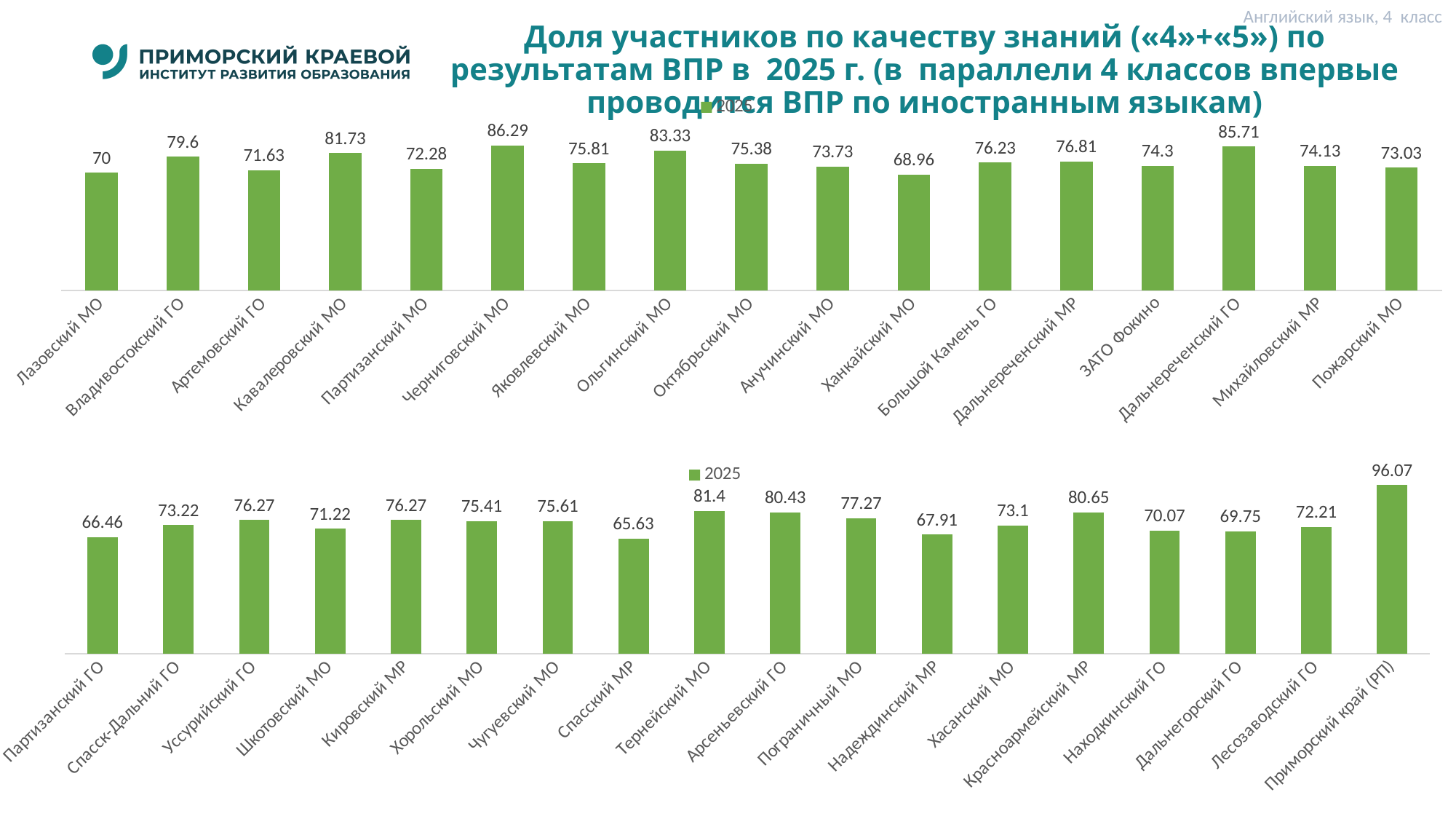
In the top chart, what is the value for Ханкайский МО? 68.96 In the bottom chart, what is the value for Приморский край (РП)? 96.07 In the top chart, what is the difference between Ольгинский МО and Лазовский МО? 13.33 In the top chart, which category has the highest value? Черниговский МО In the bottom chart, which category has the lowest value? Спасский МР In the top chart, which category has the lowest value? Ханкайский МО In the top chart, how many categories are shown? 17 In the bottom chart, how many categories are shown? 18 In the top chart, what is the value for Черниговский МО? 86.29 In the bottom chart, what is the difference between Красноармейский МР and Находкинский ГО? 10.58 What type of chart is the bottom chart? Bar chart In the bottom chart, which is larger: Тернейский МО or Арсеньевский ГО? Тернейский МО